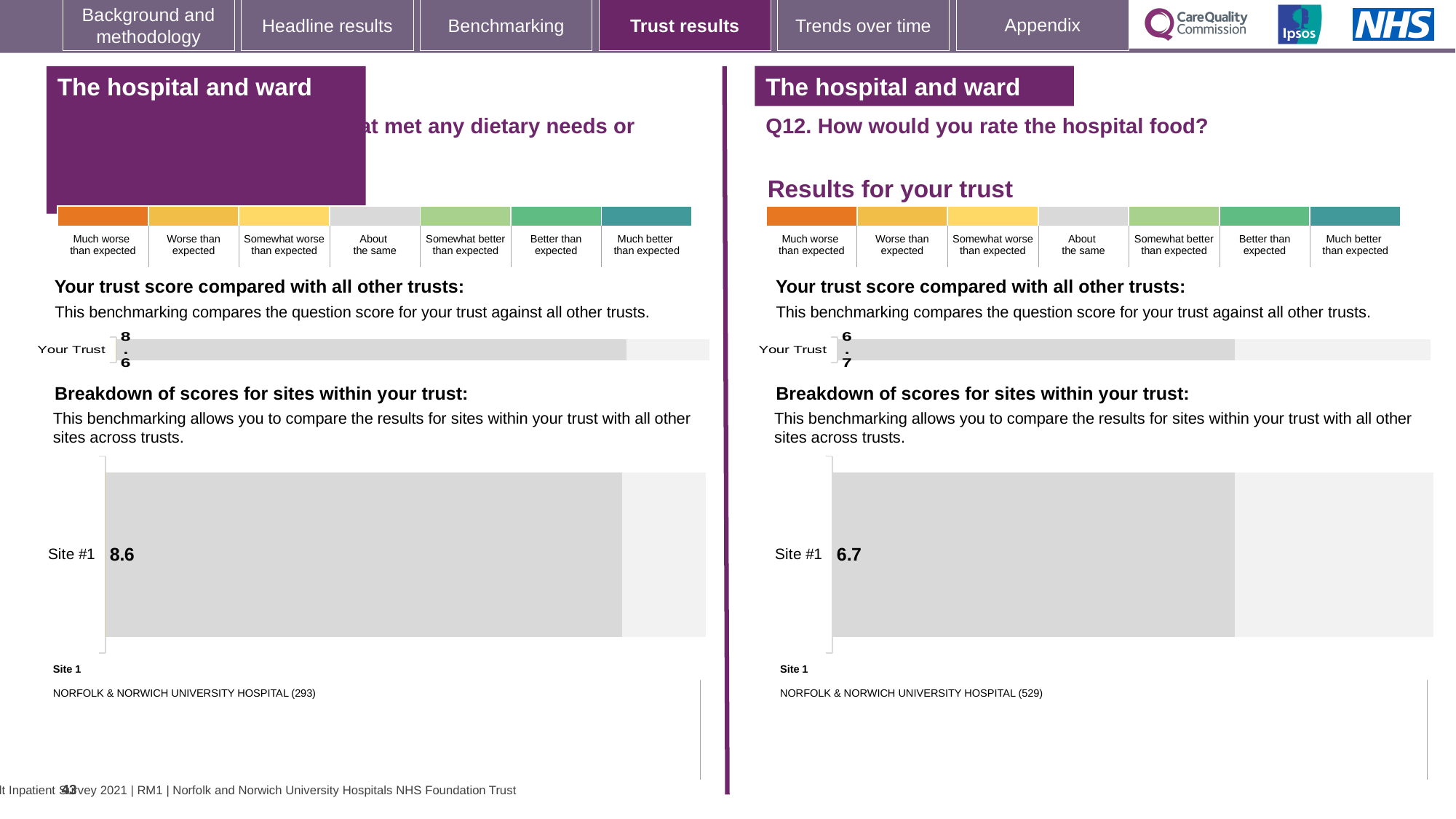
On the right half of the slide (Q12, hospital food), what is the score shown for 'Your Trust' in the trust comparison chart? 6.7 On the left half of the slide, what is the score shown for 'Your Trust' in the trust comparison chart? 8.6 What is the name of the site labelled Site 1 in the right-hand breakdown chart? NORFOLK & NORWICH UNIVERSITY HOSPITAL (529) Is the 'Your Trust' score in the right-hand trust comparison chart (Q12) greater or less than the 'Your Trust' score in the left-hand chart? less What is the name of the site labelled Site 1 in the left-hand breakdown chart? NORFOLK & NORWICH UNIVERSITY HOSPITAL (293) In the right-hand 'Breakdown of scores for sites within your trust' chart (Q12), what is the score for Site #1? 6.7 Which is larger: the Site #1 score in the left-hand breakdown chart or the Site #1 score in the right-hand breakdown chart? Left-hand (8.6) How many sites are shown in the left-hand 'Breakdown of scores for sites within your trust' chart? 1 In the left-hand 'Breakdown of scores for sites within your trust' chart, what is the score for Site #1? 8.6 How many sites are shown in the right-hand 'Breakdown of scores for sites within your trust' chart? 1 What kind of chart is used to show the Site #1 score in the right-hand breakdown chart? Bar chart What is the difference between the Site #1 score in the left-hand breakdown chart (8.6) and the Site #1 score in the right-hand breakdown chart (6.7)? 1.9